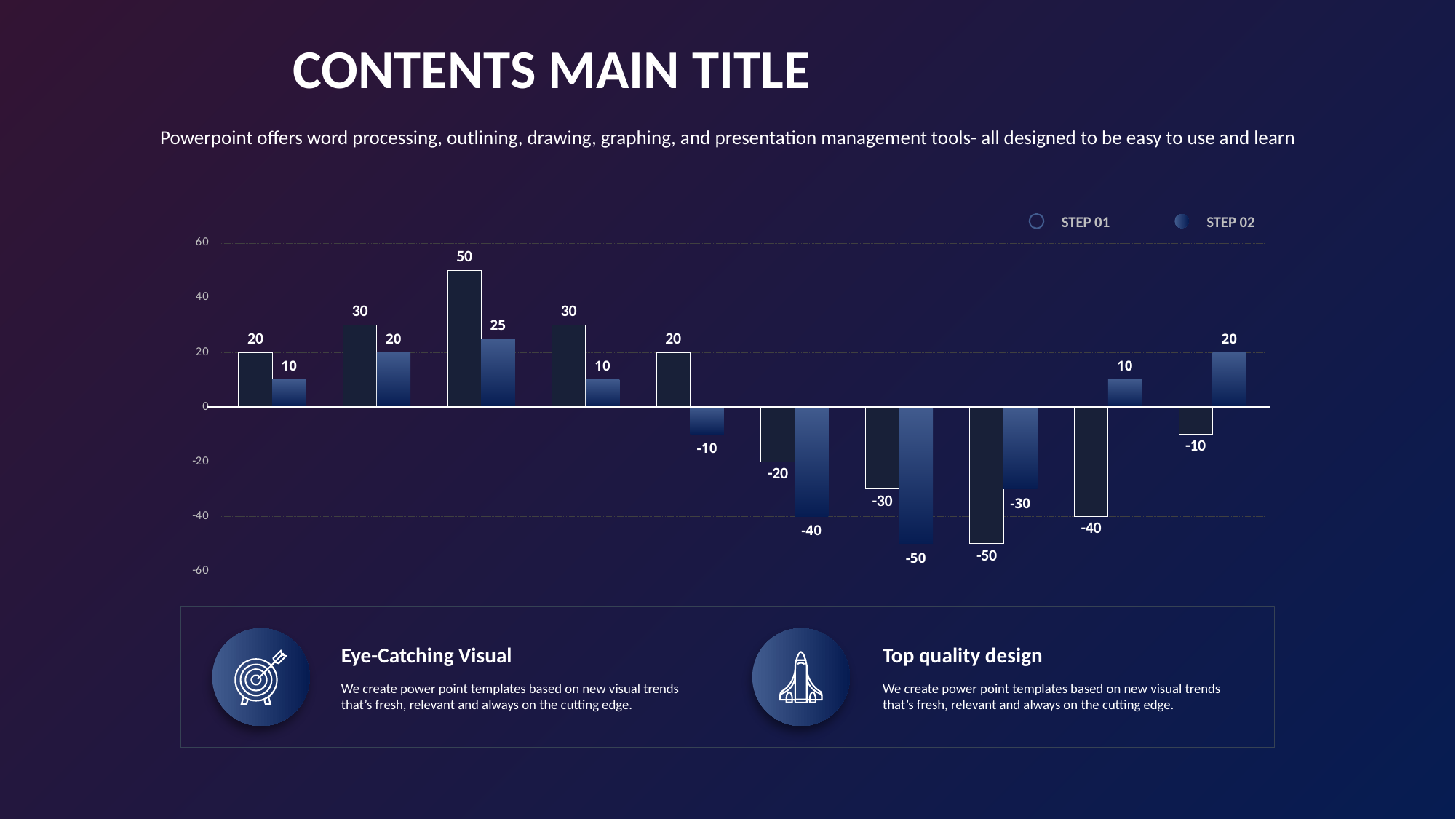
How many groups of bars are plotted along the x axis? 10 What type of chart is shown on the slide? Bar chart In the third group of bars from the left, what is the difference between the STEP 01 value and the STEP 02 value? 25 What is the STEP 01 value in the first group of bars from the left? 20 In the rightmost group of bars, which series has the larger value, STEP 01 or STEP 02? STEP 02 How many series does the chart legend list? 2 What is the highest value shown for the STEP 01 series? 50 What is the STEP 02 value in the third group of bars from the left? 25 What is the lowest value shown for the STEP 01 series? -50 What is the highest value shown for the STEP 02 series? 25 What is the lowest value shown for the STEP 02 series? -50 What are the names of the two series in the chart legend? STEP 01 and STEP 02